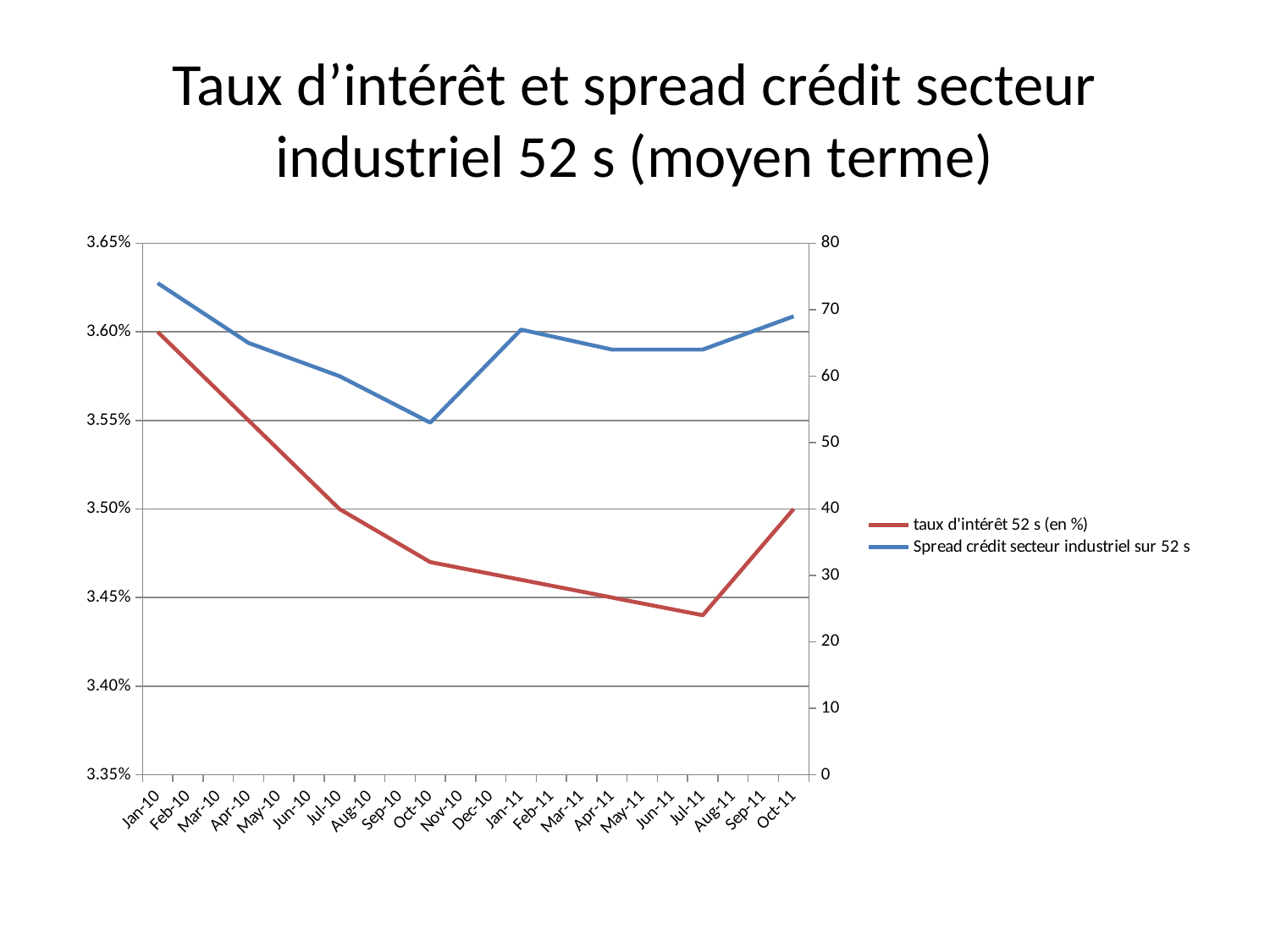
What is the value of 'taux d'intérêt 52 s (en %)' in Oct-11? 3.50% How many series does the legend list? 2 Does 'taux d'intérêt 52 s (en %)' rise or fall from Jan-10 to Jul-11? fall In which month is 'Spread crédit secteur industriel sur 52 s' at its highest? Jan-10 What is the value of 'taux d'intérêt 52 s (en %)' in Jul-10? 3.50% What is the value of 'taux d'intérêt 52 s (en %)' in Jan-10? 3.60% How many month labels are shown on the x axis? 22 In which month is 'Spread crédit secteur industriel sur 52 s' at its lowest? Oct-10 Is the value of 'Spread crédit secteur industriel sur 52 s' in Oct-10 greater or less than 60? less What colour is the line for 'Spread crédit secteur industriel sur 52 s'? blue What type of chart is shown on the slide? line chart In which month is 'taux d'intérêt 52 s (en %)' at its lowest? Jul-11